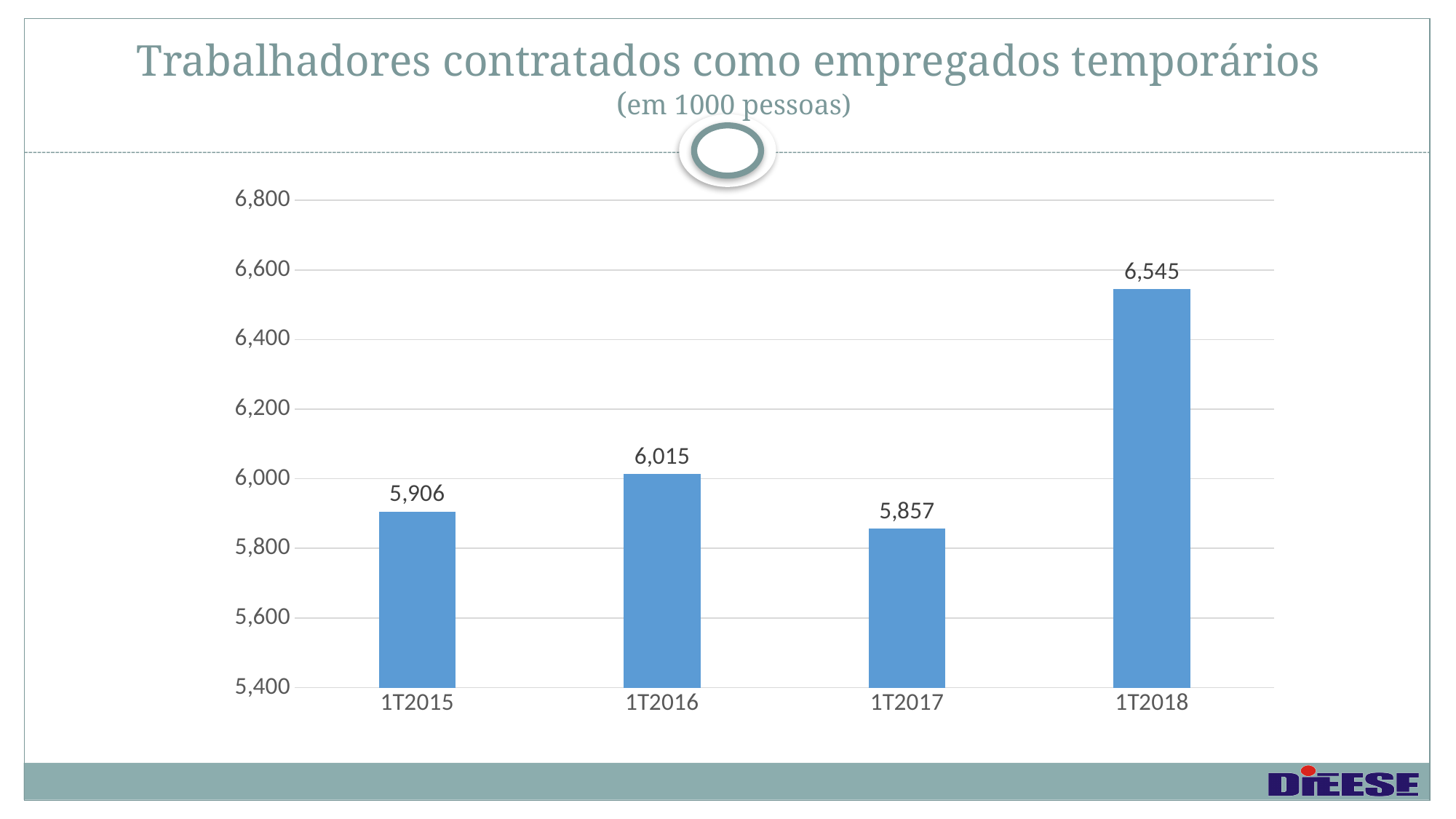
Which is larger, the value for 1T2015 or the value for 1T2017? 1T2015 What is the value for 1T2017? 5,857 What is the difference between the values for 1T2018 and 1T2017? 688 How many periods are shown on the x axis? 4 What kind of chart is shown on the slide? bar chart What is the value for 1T2016? 6,015 Is the value for 1T2016 greater or less than 6,000? greater What is the difference between the values for 1T2016 and 1T2015? 109 Which period has the highest value? 1T2018 What is the value for 1T2018? 6,545 Which period has the lowest value? 1T2017 What is the value for 1T2015? 5,906